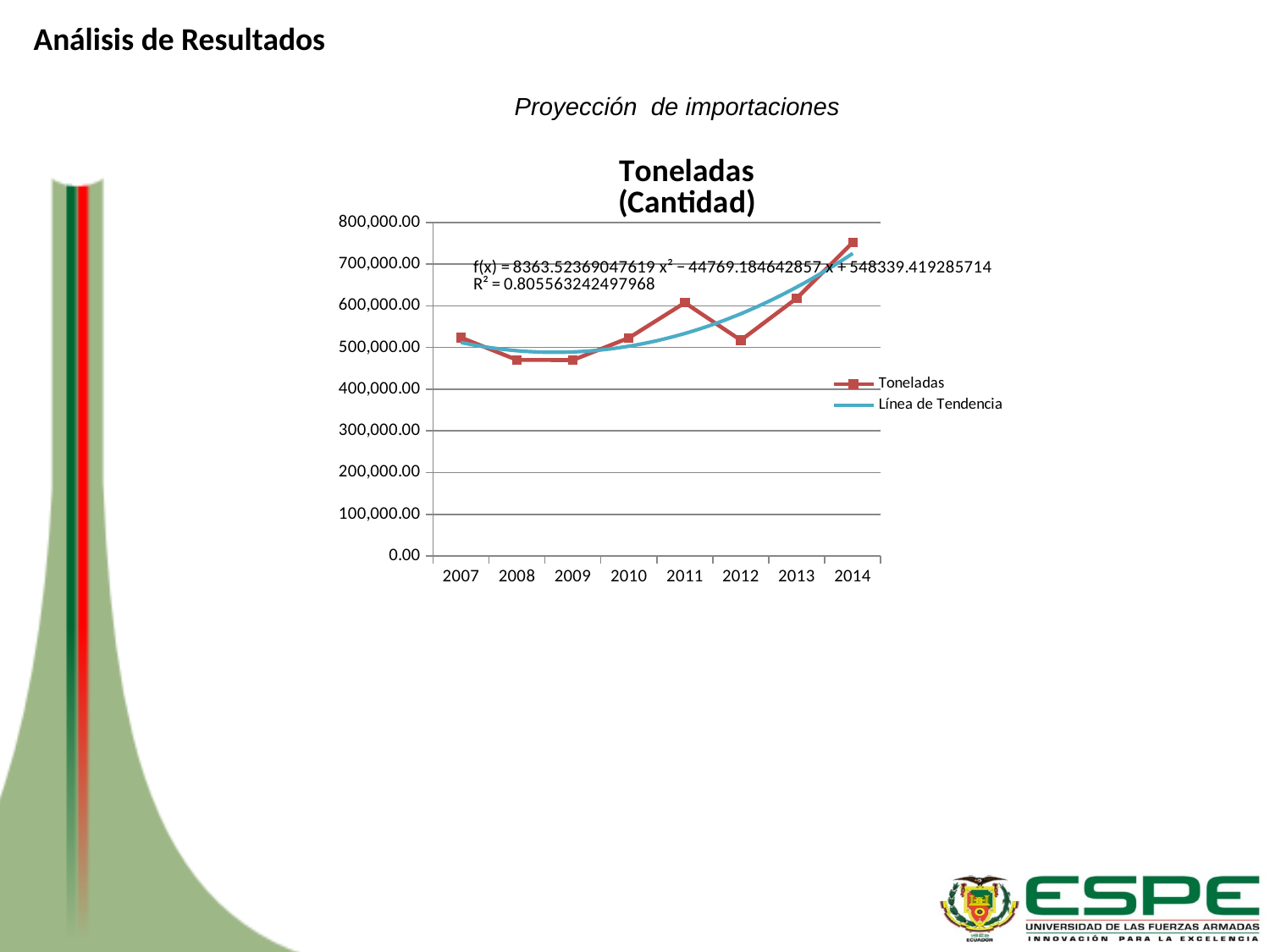
What kind of chart is shown on the slide? line chart Which year has the larger Toneladas value, 2011 or 2012? 2011 Which year has the highest value for Toneladas? 2014 What is the title of the chart? Toneladas (Cantidad) Is the Toneladas value for 2011 greater or less than 500,000.00? greater How many series does the legend list? 2 How many years are plotted along the x axis? 8 Does the Toneladas series rise or fall between 2012 and 2014? rise Is the Toneladas value for 2013 greater or less than 700,000.00? less Is the Toneladas value for 2008 greater or less than 500,000.00? less What R² value is printed on the chart for the trend line? 0.805563242497968